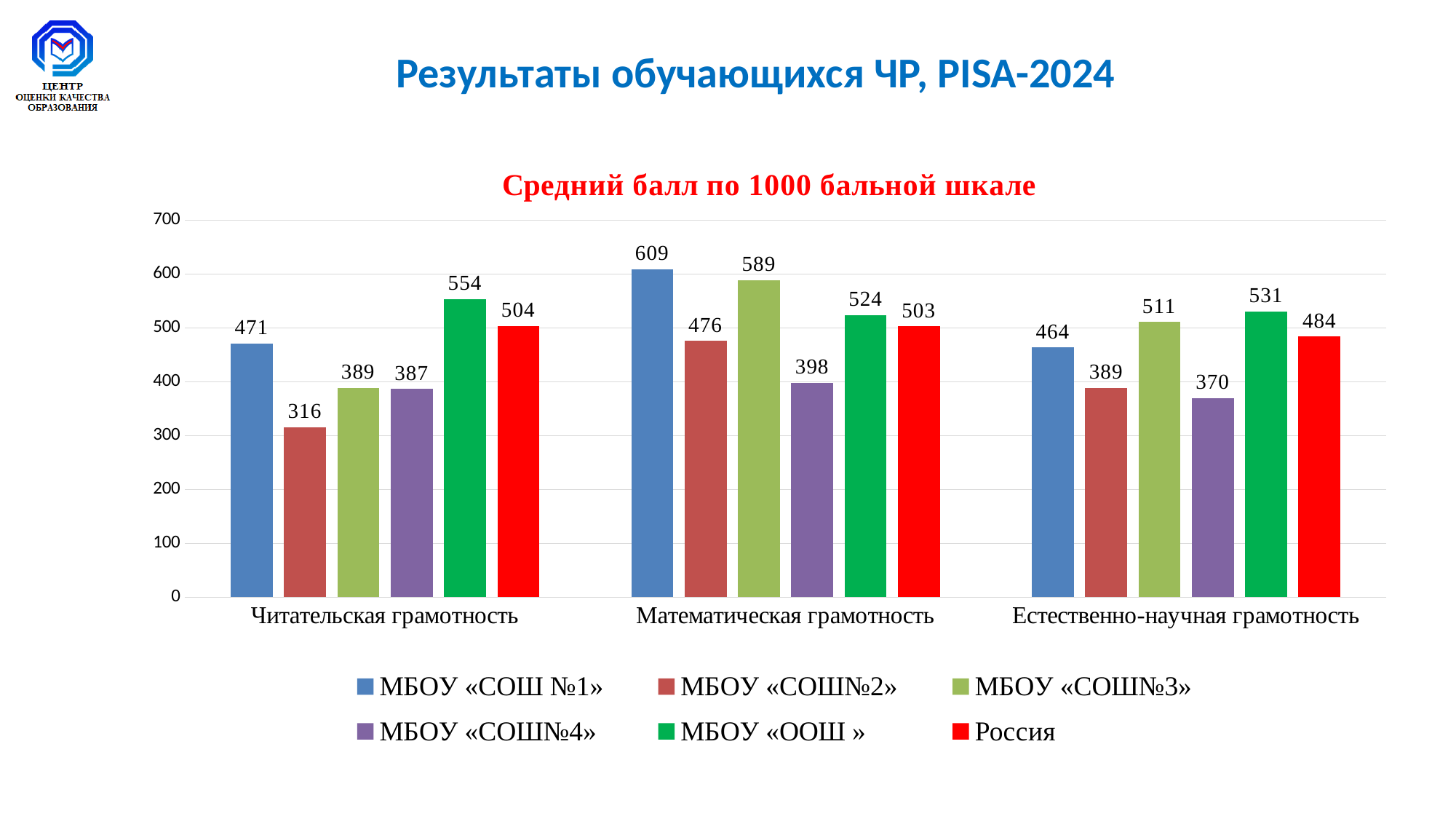
How many series does the legend list? 6 What is the difference between МБОУ «ООШ » and Россия in Читательская грамотность? 50 Which series has the lowest value in Читательская грамотность? МБОУ «СОШ№2» Which series has the highest value in Математическая грамотность? МБОУ «СОШ №1» Which is larger in Естественно-научная грамотность: МБОУ «СОШ№3» or МБОУ «ООШ »? МБОУ «ООШ » What is the value for Россия in Математическая грамотность? 503 Is the value for МБОУ «СОШ№2» in Математическая грамотность greater or less than 500? less What is the value for МБОУ «СОШ №1» in Читательская грамотность? 471 What is the value for МБОУ «СОШ№4» in Естественно-научная грамотность? 370 What is the title of the chart? Средний балл по 1000 бальной шкале What kind of chart is shown on the slide? bar chart How many categories are shown on the x axis? 3